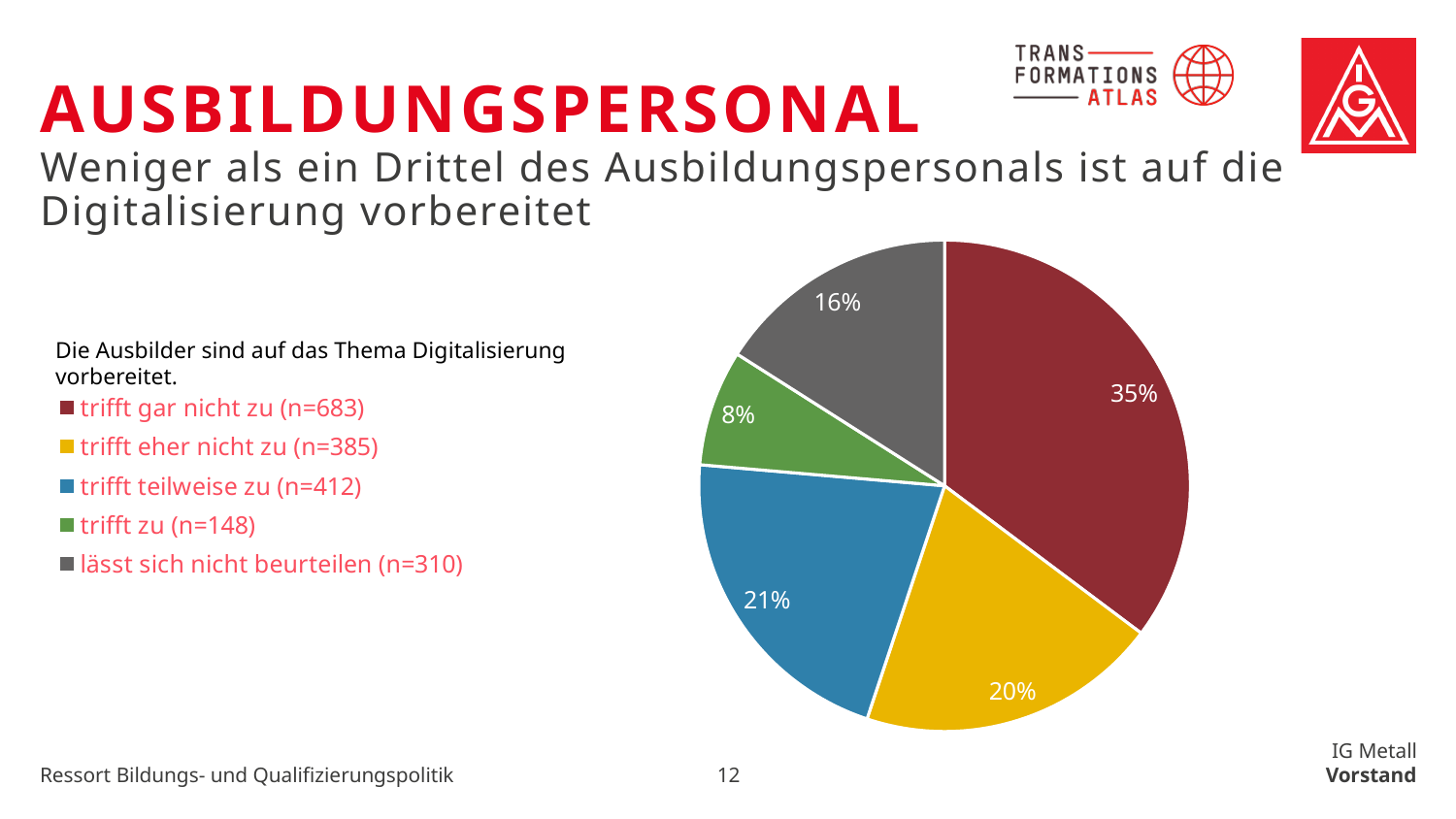
Which category has the smallest slice of the pie? trifft zu (n=148) How many slices does the pie chart have? 5 What share of the pie does "trifft zu (n=148)" have? 8% Which category has the largest slice of the pie? trifft gar nicht zu (n=683) What share of the pie does "trifft gar nicht zu (n=683)" have? 35% What colour is the slice for "trifft eher nicht zu (n=385)"? yellow Which is larger: the slice for "lässt sich nicht beurteilen (n=310)" or the slice for "trifft zu (n=148)"? lässt sich nicht beurteilen (n=310) What is the value shown for "lässt sich nicht beurteilen (n=310)"? 16% What is the value shown for "trifft teilweise zu (n=412)"? 21% What is the difference in percentage points between "trifft gar nicht zu (n=683)" and "trifft eher nicht zu (n=385)"? 15 How many entries does the legend of the pie chart list? 5 What kind of chart is shown on the slide? pie chart